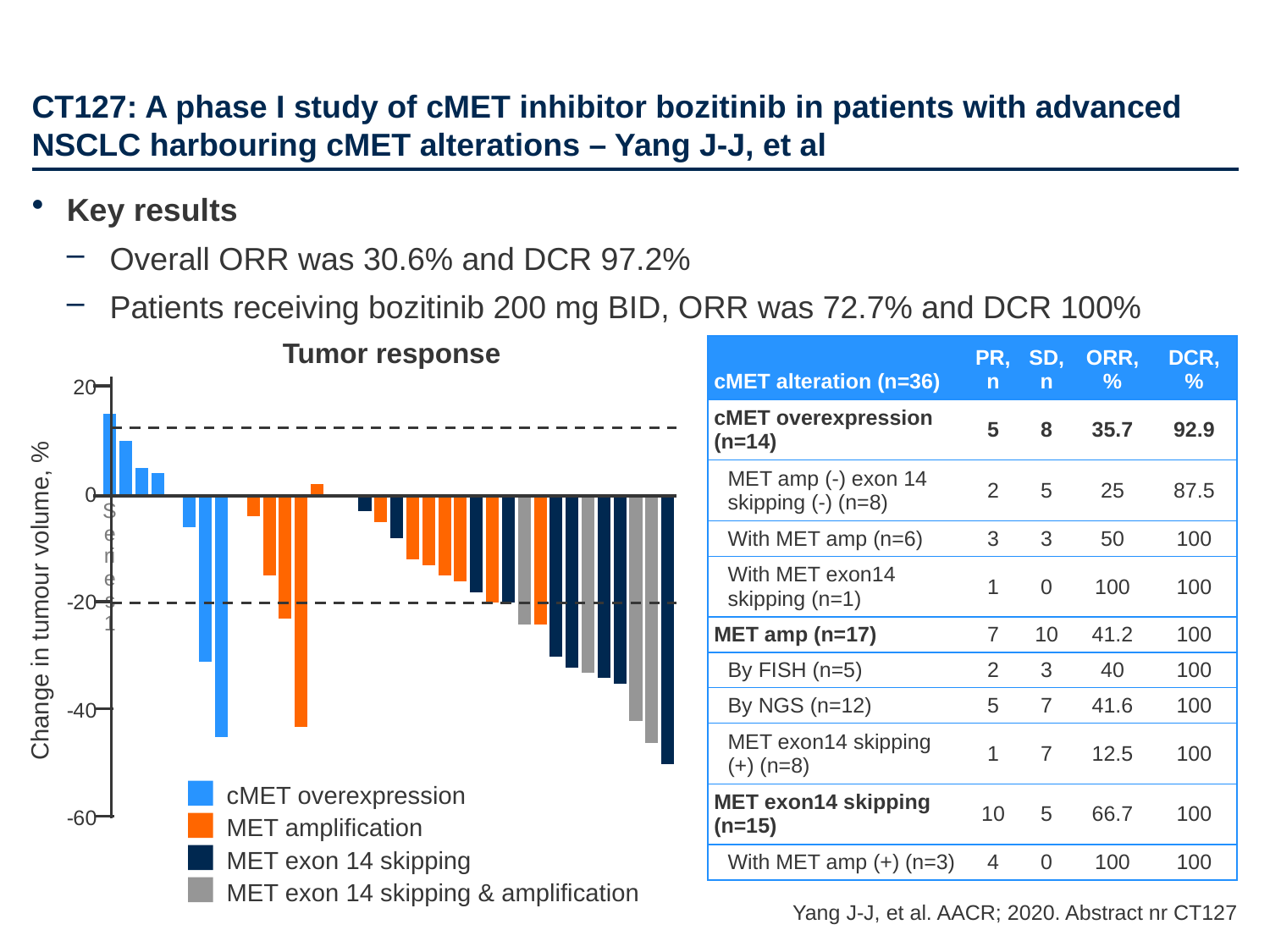
In the "Tumor response" chart, is the value for the rightmost bar greater or less than -40? less In the "Tumor response" chart, is the value for the lowest orange (MET amplification) bar greater or less than -40? less In the "Tumor response" chart, do the bar values generally rise or fall from left to right? Fall What is the y-axis label of the "Tumor response" chart? Change in tumour volume, % In the "Tumor response" chart, which legend group does the lowest (rightmost) bar belong to? MET exon 14 skipping How many entries does the legend of the "Tumor response" chart list? 4 What is the title of the chart on the slide? Tumor response In the "Tumor response" chart, is the value for the leftmost bar greater or less than 0? greater In the "Tumor response" chart, which is larger: the leftmost blue bar or the rightmost dark blue bar? The leftmost blue bar In the "Tumor response" chart, which legend group does the highest (leftmost) bar belong to? cMET overexpression What kind of chart is the "Tumor response" chart? Bar chart